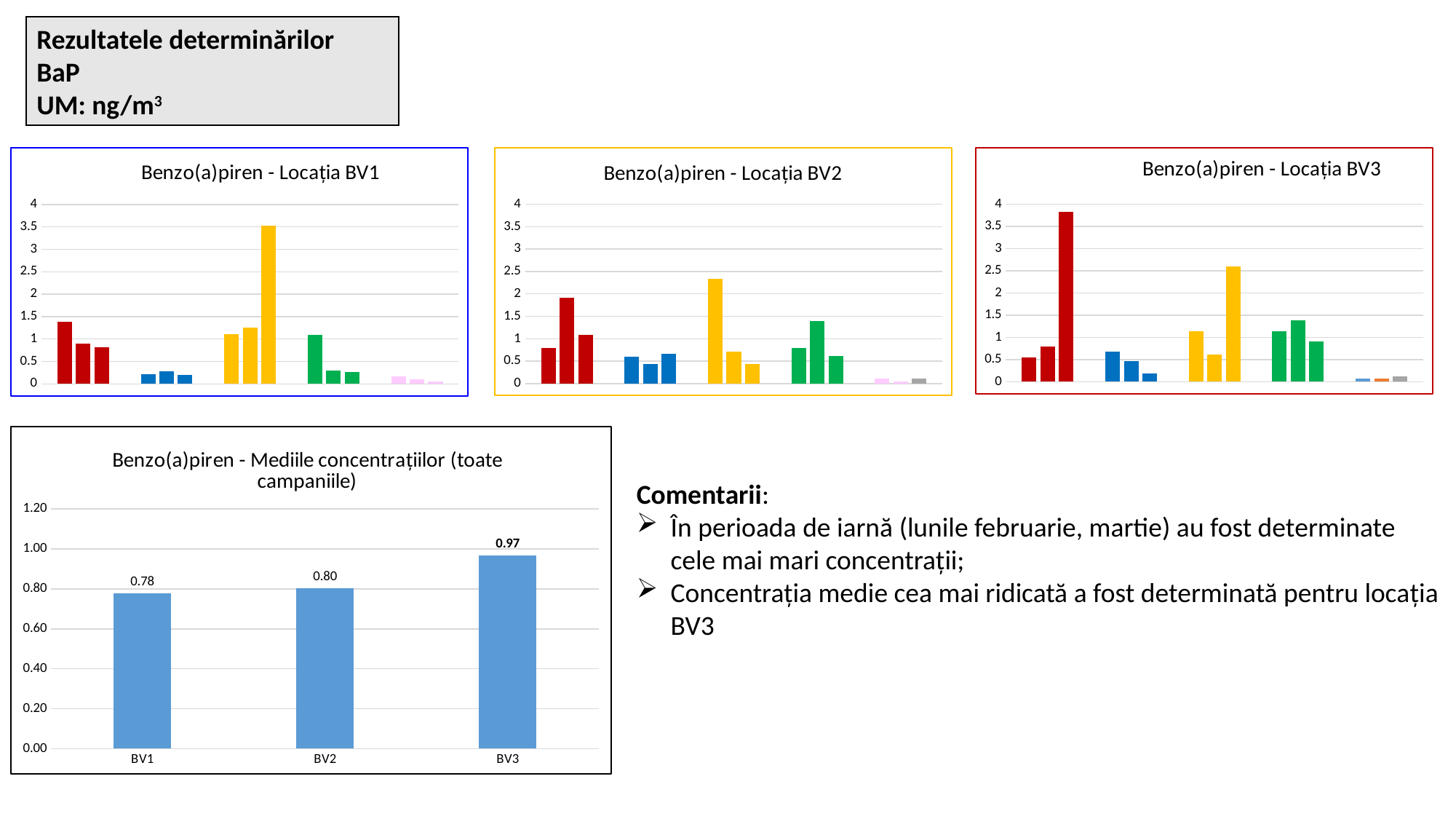
In the chart titled 'Benzo(a)piren - Mediile concentrațiilor (toate campaniile)', what is the value for BV1? 0.78 In the chart titled 'Benzo(a)piren - Mediile concentrațiilor (toate campaniile)', what is the value for BV2? 0.80 In the chart titled 'Benzo(a)piren - Mediile concentrațiilor (toate campaniile)', what is the difference between the values for BV3 and BV1? 0.19 In the chart titled 'Benzo(a)piren - Locația BV3', is the tallest bar greater or less than 3.5? greater In the chart titled 'Benzo(a)piren - Mediile concentrațiilor (toate campaniile)', which is larger, the value for BV2 or the value for BV3? BV3 In the chart titled 'Benzo(a)piren - Mediile concentrațiilor (toate campaniile)', which location has the highest value? BV3 In the chart titled 'Benzo(a)piren - Mediile concentrațiilor (toate campaniile)', which location has the lowest value? BV1 In the chart titled 'Benzo(a)piren - Mediile concentrațiilor (toate campaniile)', do the values rise or fall from BV1 to BV3? rise In the chart titled 'Benzo(a)piren - Locația BV1', is the tallest bar greater or less than 3? greater In the chart titled 'Benzo(a)piren - Mediile concentrațiilor (toate campaniile)', how many locations are shown? 3 What kind of chart is the one titled 'Benzo(a)piren - Mediile concentrațiilor (toate campaniile)'? bar chart In the chart titled 'Benzo(a)piren - Mediile concentrațiilor (toate campaniile)', what is the value for BV3? 0.97